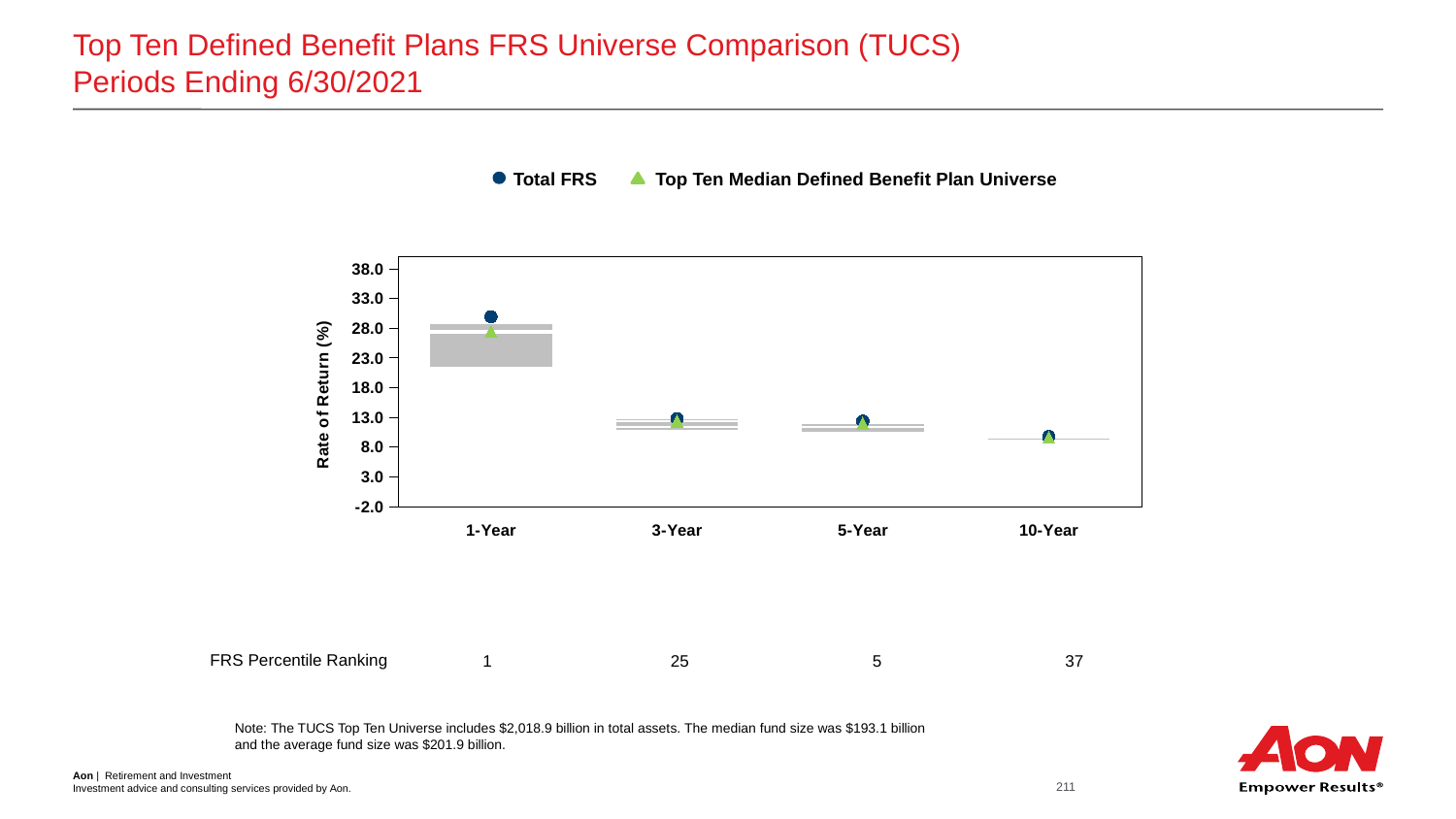
What is the FRS Percentile Ranking shown for the 3-Year period? 25 Do the Total FRS rates of return rise or fall moving from 1-Year to 10-Year along the x axis? fall How many series does the chart legend list? 2 Is the Total FRS rate of return for 10-Year greater or less than 13.0? less What is the title of the chart's y axis? Rate of Return (%) Which period shows the lowest Total FRS rate of return? 10-Year How many time periods are shown on the x axis of the chart? 4 Is the Total FRS rate of return for 1-Year greater or less than 28.0? greater For the 1-Year period, which is higher: Total FRS or the Top Ten Median Defined Benefit Plan Universe? Total FRS Is the Total FRS rate of return for 5-Year greater or less than 8.0? greater Which is larger, the Total FRS rate of return for 1-Year or for 10-Year? 1-Year Which period shows the highest Total FRS rate of return? 1-Year